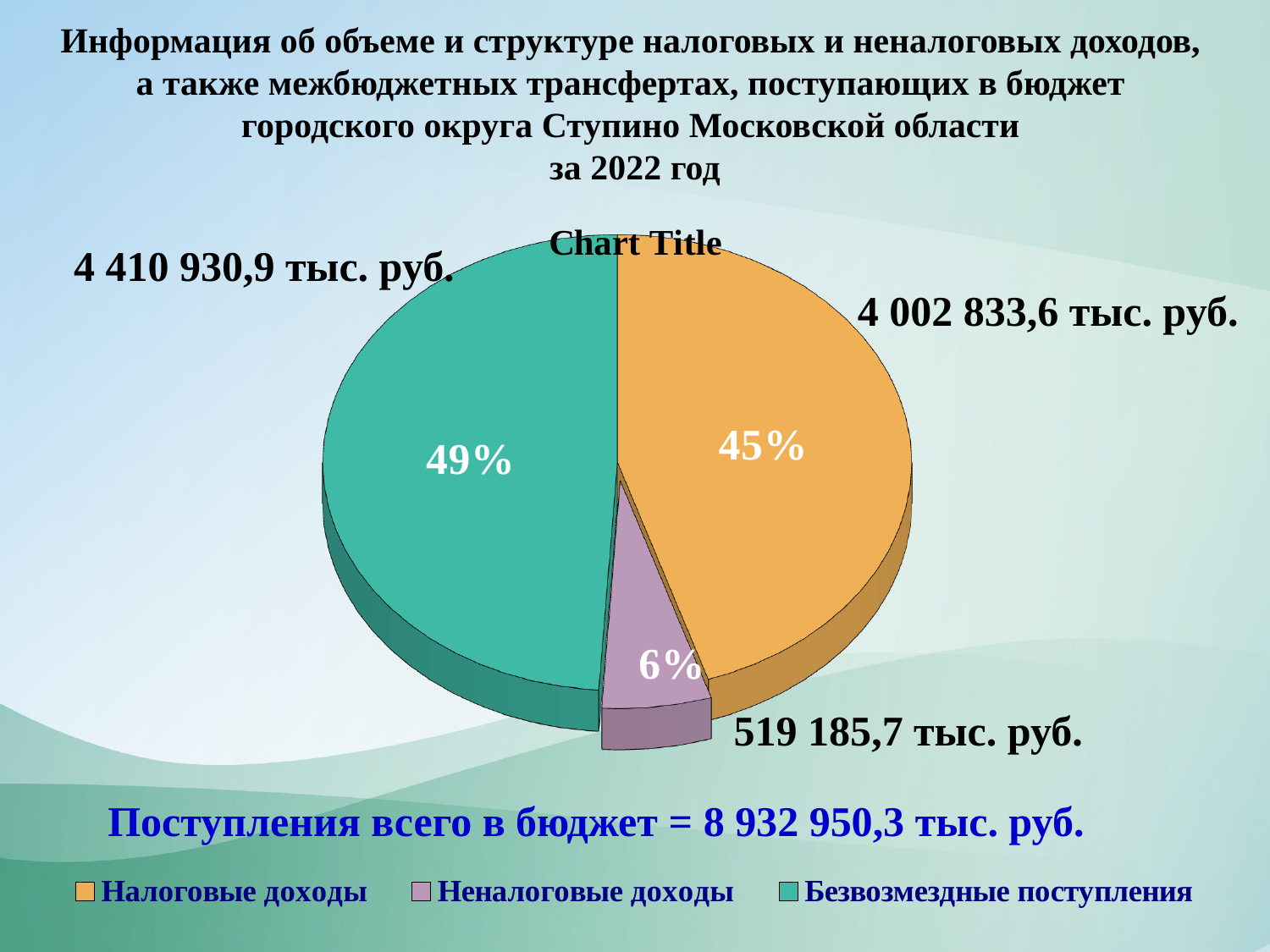
Which is larger, the value for Налоговые доходы or the value for Неналоговые доходы? Налоговые доходы What is the difference between the values for Безвозмездные поступления and Налоговые доходы? 408 097,3 тыс. руб. What share of the pie does Налоговые доходы represent? 45% What kind of chart is shown on the slide? Pie chart What share of the pie does Неналоговые доходы represent? 6% What is the value shown for Неналоговые доходы? 519 185,7 тыс. руб. What colour is the slice for Налоговые доходы? Orange What is the value shown for Безвозмездные поступления? 4 410 930,9 тыс. руб. How many slices does the pie chart have? 3 Which category has the largest share of the pie? Безвозмездные поступления What share of the pie does Безвозмездные поступления represent? 49% Which category has the smallest share of the pie? Неналоговые доходы